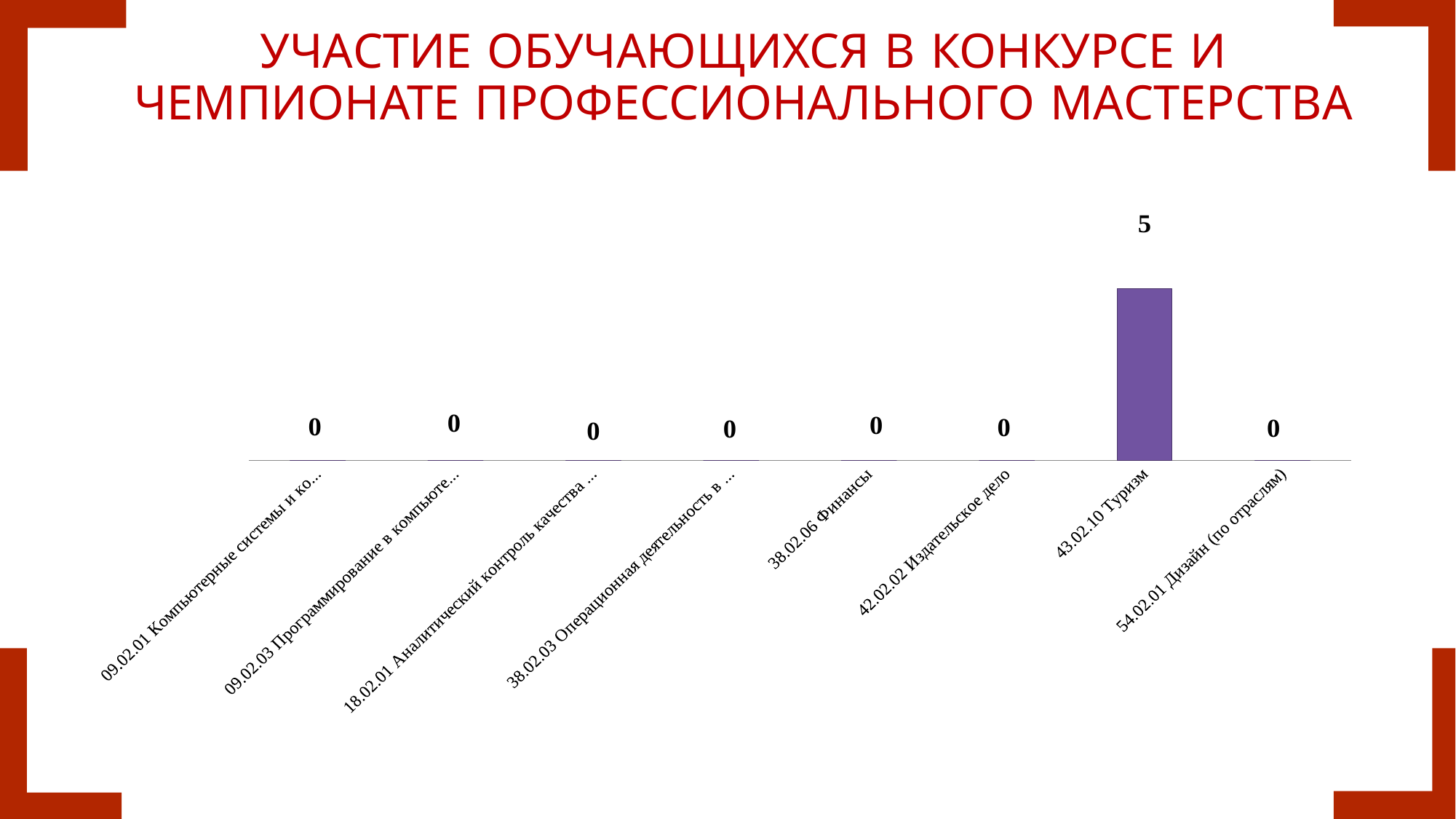
How many categories have a value of 0? 7 What is the value for 38.02.06 Финансы? 0 Which category has the highest value? 43.02.10 Туризм What colour is the bar for 43.02.10 Туризм? purple Which is larger, the value for 43.02.10 Туризм or for 42.02.02 Издательское дело? 43.02.10 Туризм What is the difference between the values for 43.02.10 Туризм and 38.02.06 Финансы? 5 What is the title of the slide? УЧАСТИЕ ОБУЧАЮЩИХСЯ В КОНКУРСЕ И ЧЕМПИОНАТЕ ПРОФЕССИОНАЛЬНОГО МАСТЕРСТВА What kind of chart is shown on the slide? bar chart How many categories are shown on the x axis? 8 What is the value for 54.02.01 Дизайн (по отраслям)? 0 What is the value for 43.02.10 Туризм? 5 What is the value for 42.02.02 Издательское дело? 0